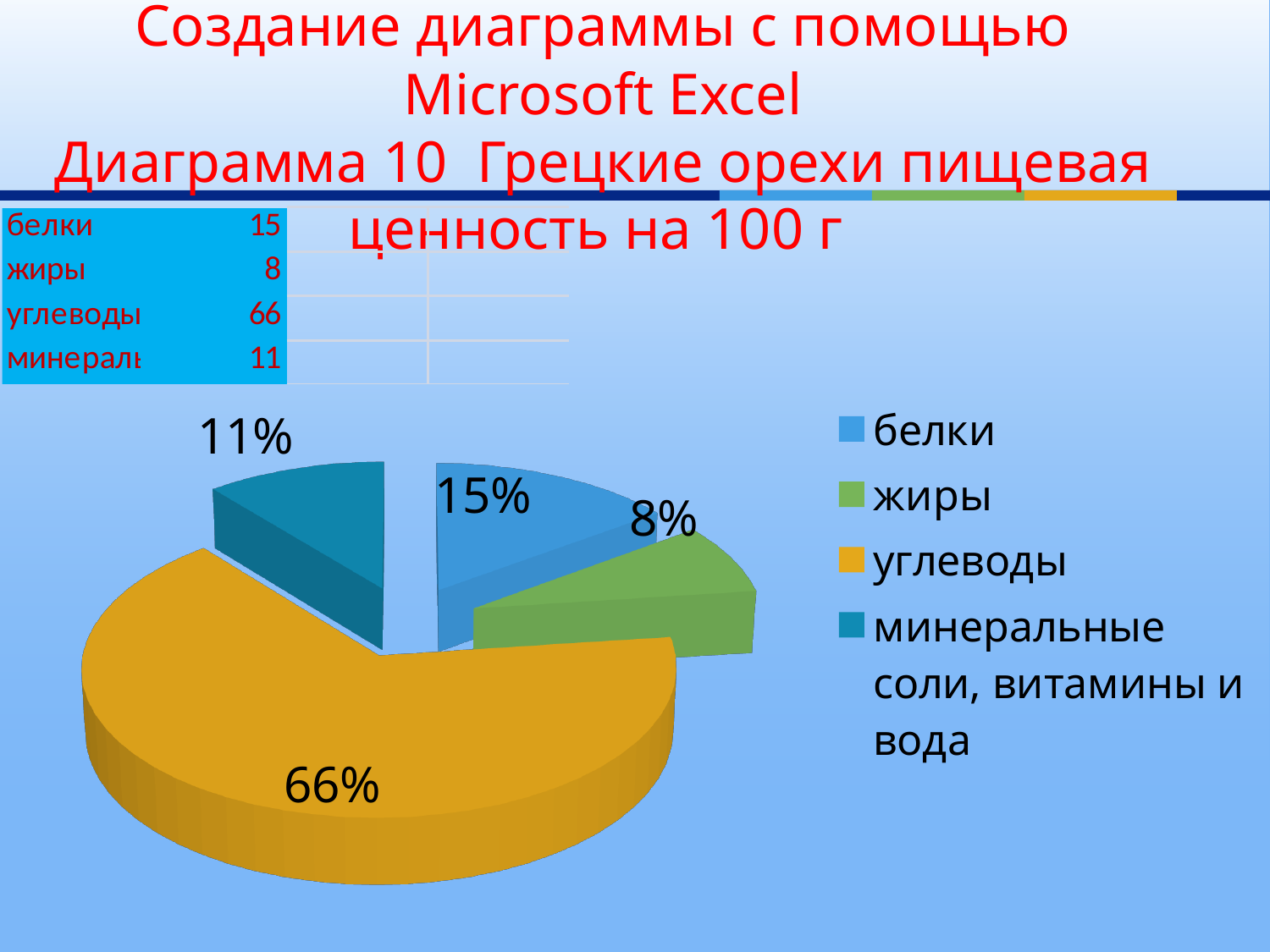
How many slices does the pie chart have? 4 What percentage of the pie is labelled for углеводы? 66% What colour is the углеводы slice in the pie chart? yellow/orange Which category has the largest slice of the pie? углеводы How many entries does the legend list? 4 What kind of chart is shown on the slide? pie chart What percentage of the pie is labelled for белки? 15% What is the difference in percentage points between the углеводы slice and the белки slice? 51 Which slice is larger, белки or минеральные соли, витамины и вода? белки What percentage of the pie is labelled for минеральные соли, витамины и вода? 11% What percentage of the pie is labelled for жиры? 8% Which category has the smallest slice of the pie? жиры